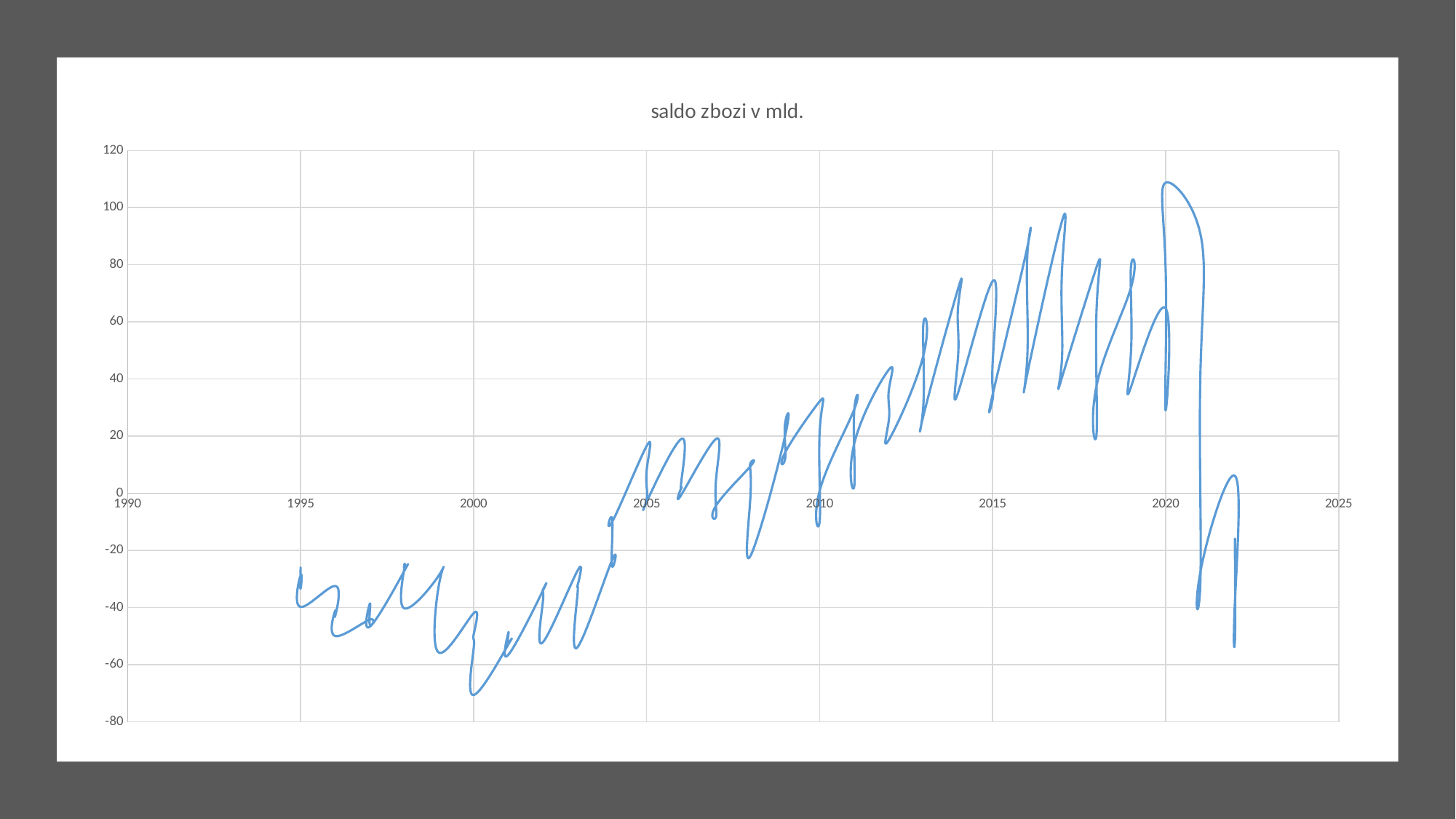
Is the peak value reached around 2017 greater or less than 80? greater Around which year on the x axis does the line reach its highest value? 2020 Is the highest value of the line, reached around 2020, greater or less than 100? greater What kind of chart is shown on the slide? line chart Is the value of the line at the start of the series, around 1995, greater or less than -20? less Which is larger: the peak value around 2020 or the peak value around 2014? the peak around 2020 Overall, do the values rise or fall along the x axis from 1995 to 2020? rise Around which year on the x axis does the line reach its lowest value? 2000 What is the highest tick value shown on the y axis? 120 What is the title of the chart? saldo zbozi v mld.